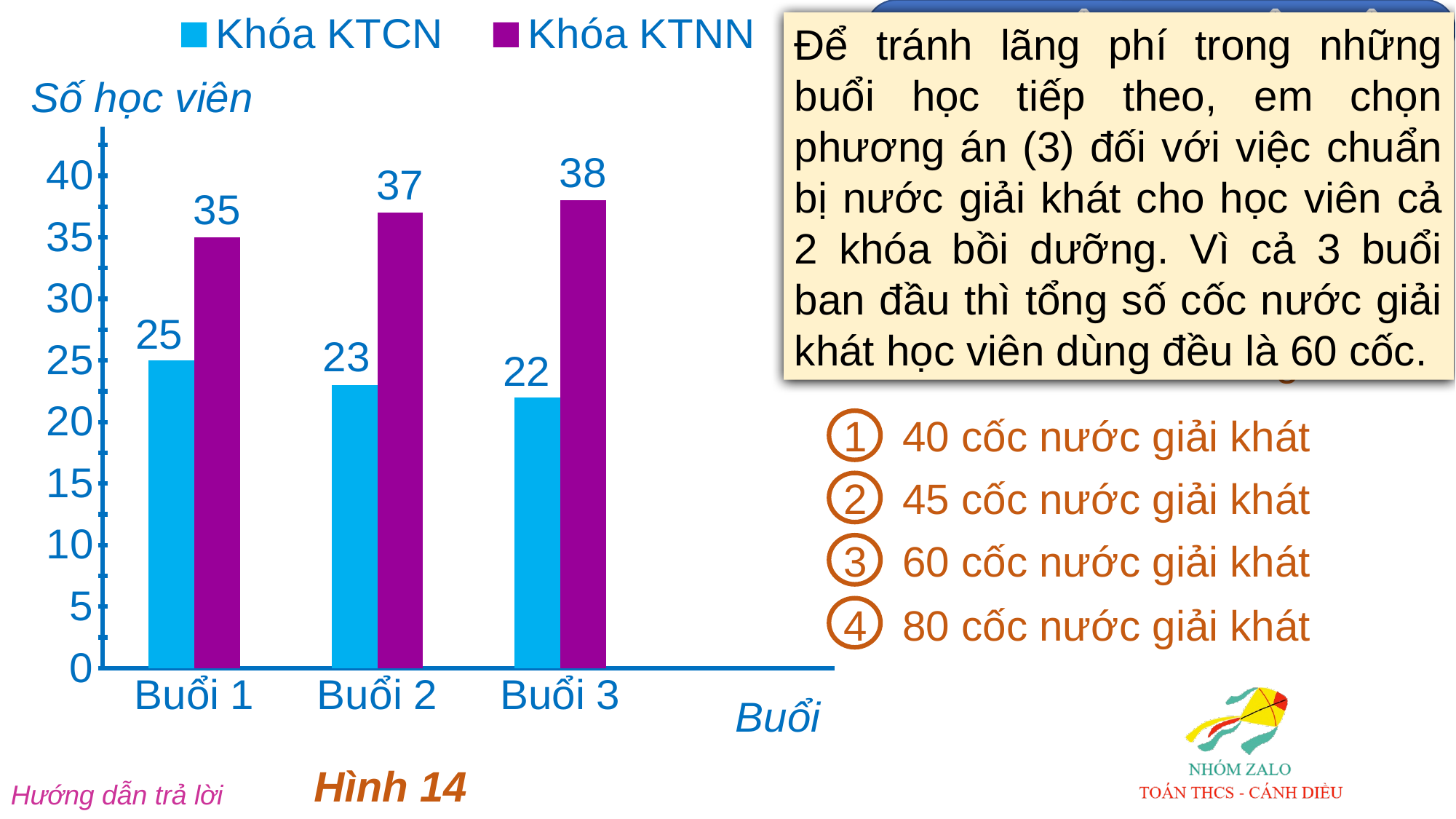
What is the value for Khóa KTCN in Buổi 3? 22 What is the value for Khóa KTCN in Buổi 1? 25 How many sessions (Buổi) are shown on the x axis? 3 What is the difference between Khóa KTNN and Khóa KTCN in Buổi 1? 10 What kind of chart is shown? Bar chart Which session (Buổi) has the lowest value for Khóa KTCN? Buổi 3 How many series does the legend list? 2 What is the label of the vertical axis? Số học viên Do the values for Khóa KTCN rise or fall from Buổi 1 to Buổi 3? Fall Which is larger in Buổi 2: Khóa KTCN or Khóa KTNN? Khóa KTNN What is the value for Khóa KTNN in Buổi 2? 37 Which session (Buổi) has the highest value for Khóa KTNN? Buổi 3